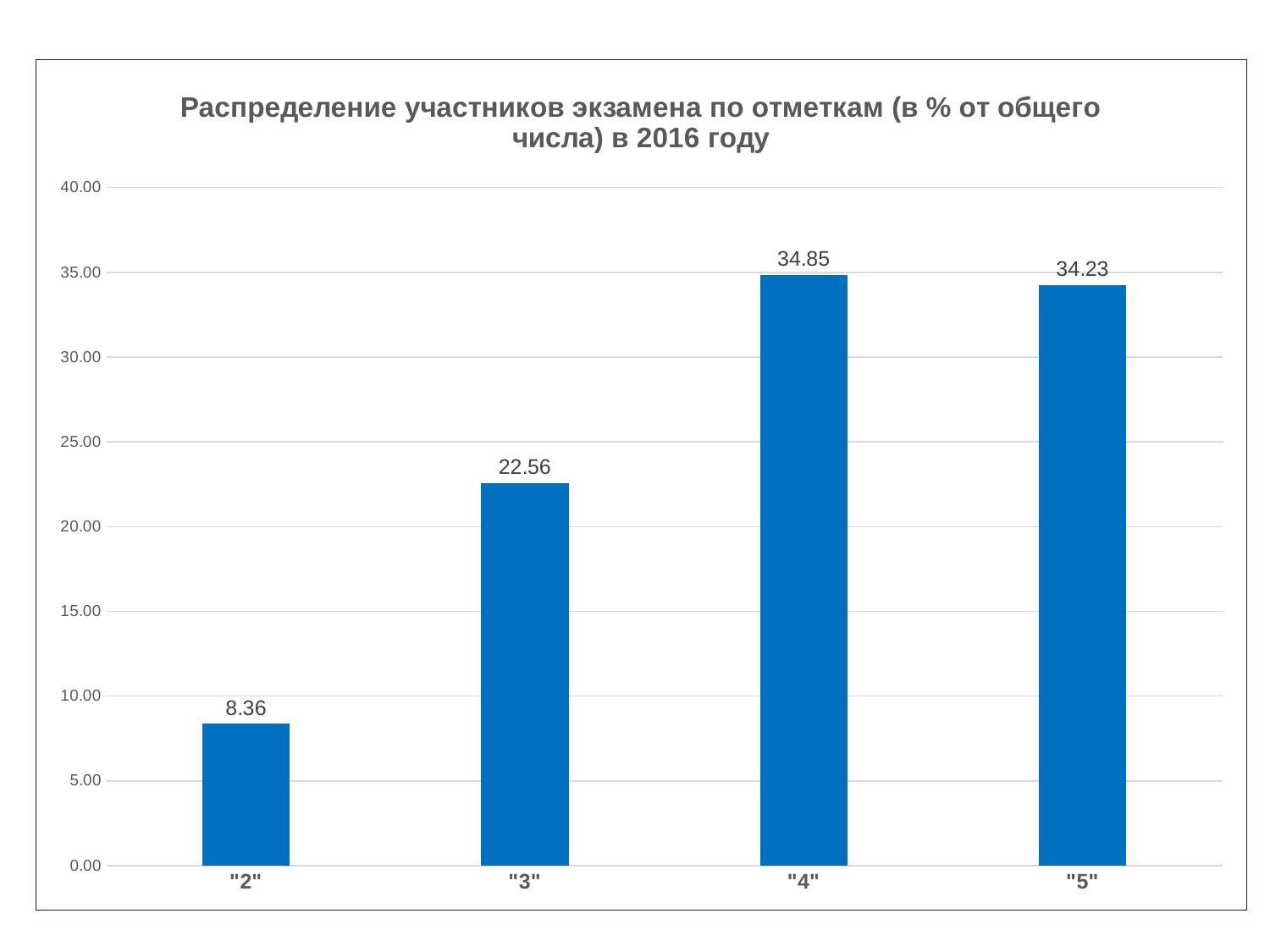
What is the difference between the values for "3" and "2"? 14.20 How many categories are shown on the x axis? 4 What is the value for the "5" category? 34.23 Is the value for "3" greater or less than 20.00? greater What is the difference between the values for "4" and "5"? 0.62 Which category has the lowest value? "2" What is the value for the "2" category? 8.36 What is the value for the "3" category? 22.56 Which is larger, the value for "3" or the value for "5"? "5" What is the value for the "4" category? 34.85 Which category has the highest value? "4" What kind of chart is shown on the slide? bar chart